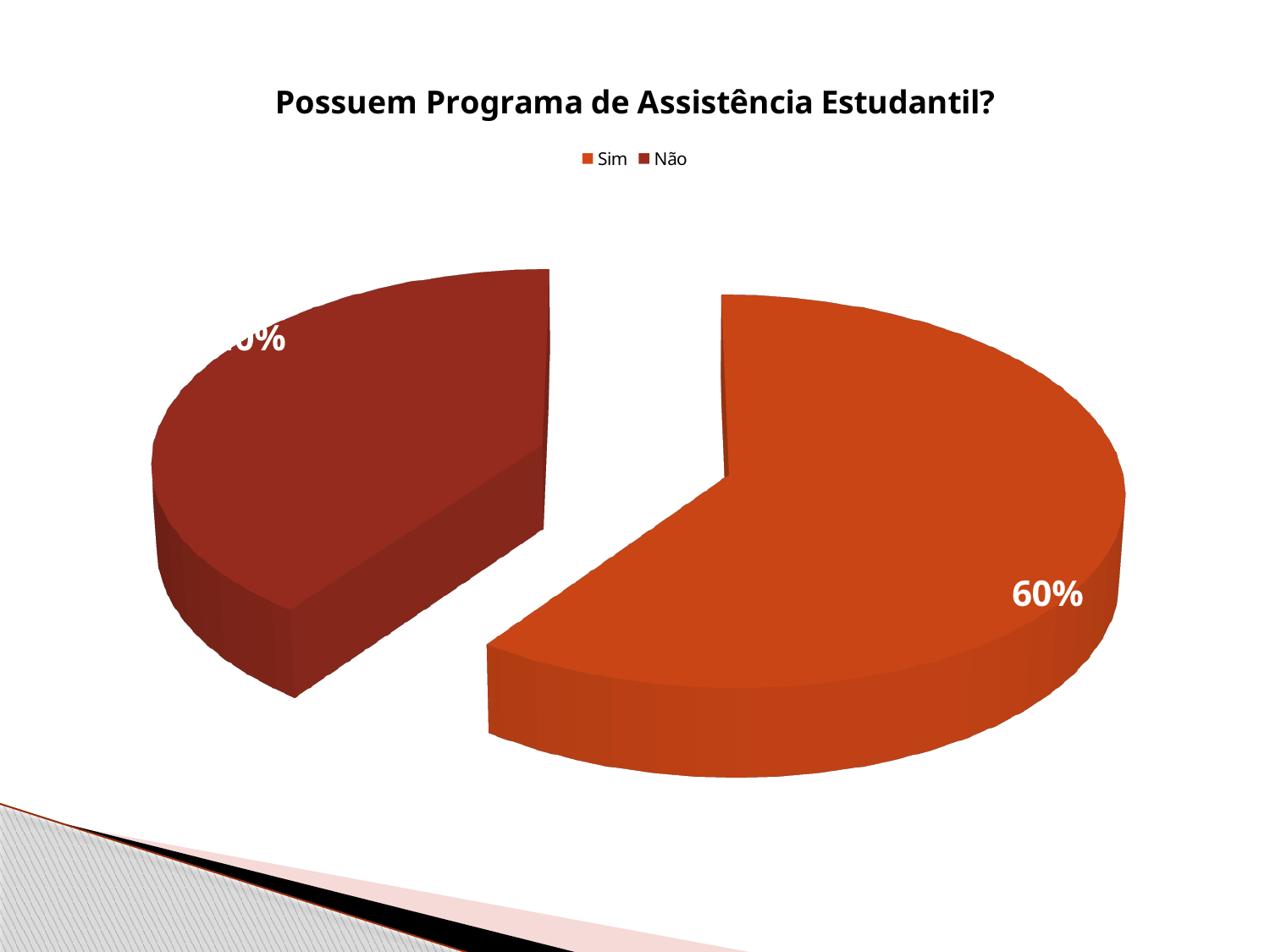
Is the share of the "Sim" slice greater or less than 50%? greater Which slice is the smallest in the pie chart? Não Which is larger, the "Sim" slice or the "Não" slice? Sim What is the title of the chart? Possuem Programa de Assistência Estudantil? What percentage of the pie does the "Sim" slice represent? 60% How many slices does the pie chart have? 2 How many entries does the legend list? 2 What are the two entries shown in the legend? Sim and Não Which slice is the largest in the pie chart? Sim What share of the pie is taken by "Sim"? 60% What kind of chart is shown on the slide? pie chart